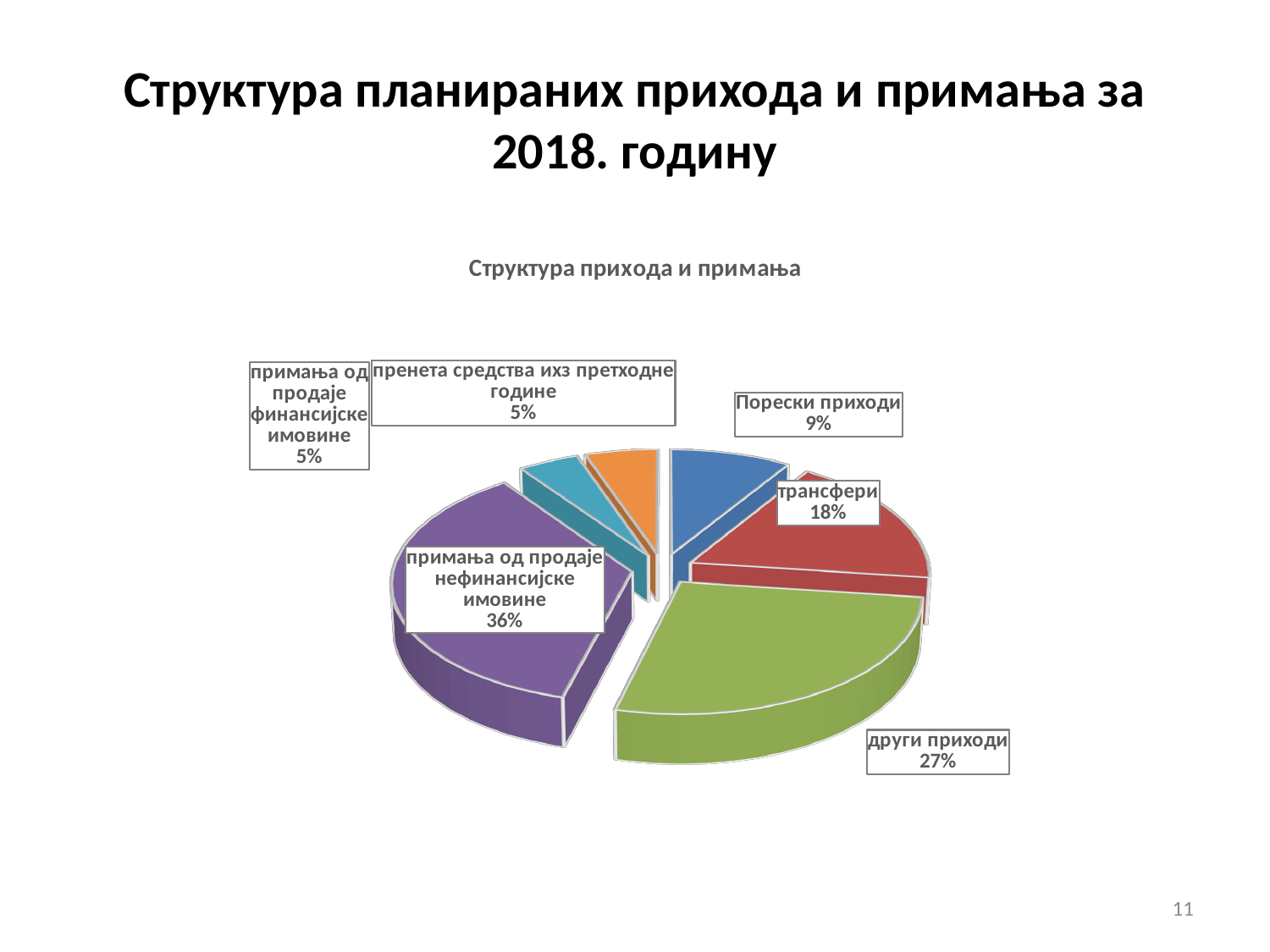
What is the title of the chart? Структура прихода и примања What kind of chart is shown on the slide? pie chart Which category has the largest share of the pie? примања од продаје нефинансијске имовине What share of the pie is labelled for 'пренета средства ихз претходне године'? 5% What share of the pie is labelled for 'други приходи'? 27% Which is larger, the share for 'трансфери' or the share for 'Порески приходи'? трансфери What share of the pie is labelled for 'примања од продаје нефинансијске имовине'? 36% What is the difference in percentage points between 'други приходи' and 'трансфери'? 9 What colour is the slice for 'други приходи'? green How many slices does the pie chart have? 6